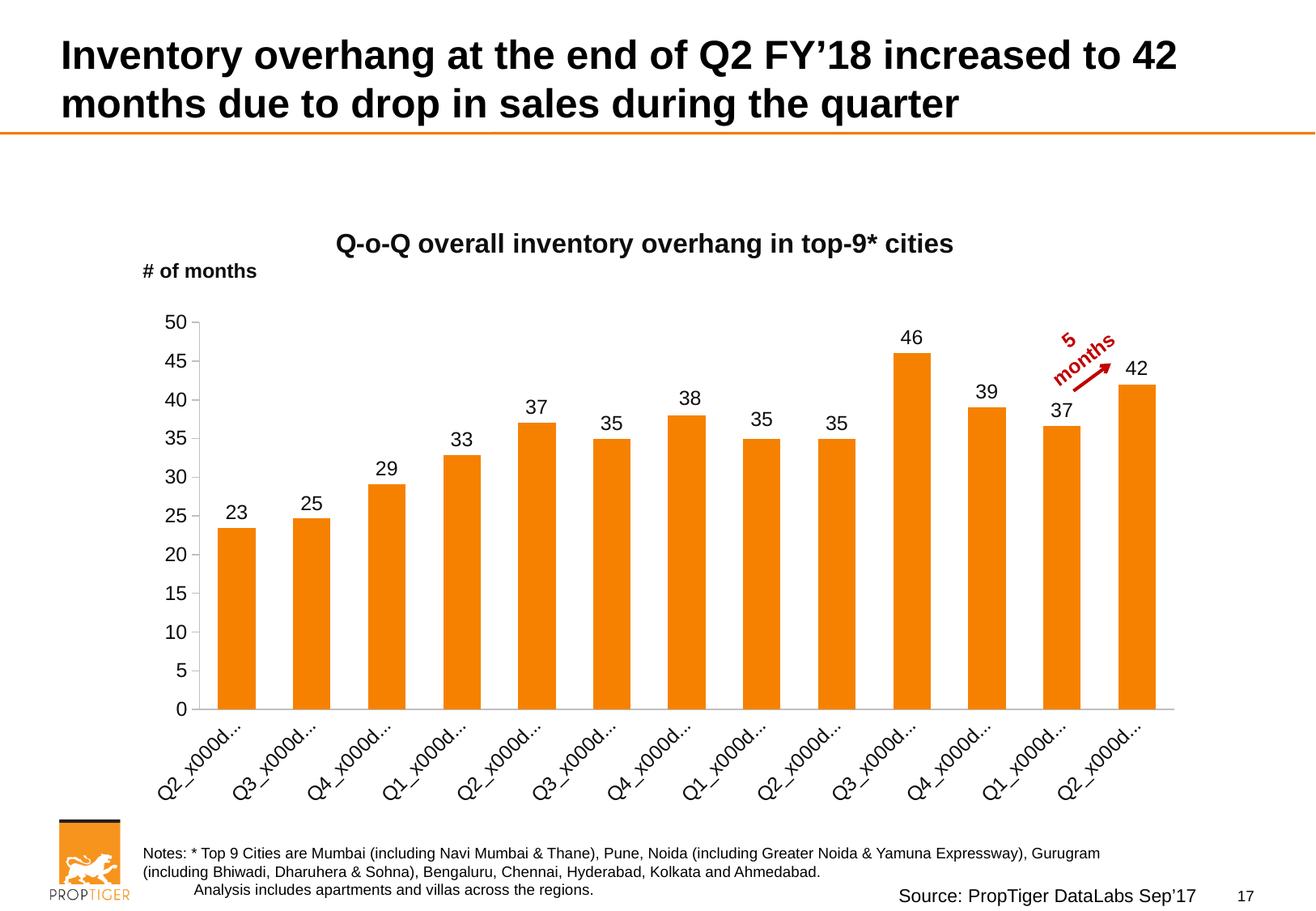
Which is larger, the value of the tenth bar or the value of the eleventh bar? the tenth bar (46) Do the values generally rise or fall from left to right across the chart? rise What kind of chart is shown on the slide? bar chart What is the value of the last (rightmost) bar in the chart? 42 What is the title of the chart? Q-o-Q overall inventory overhang in top-9* cities What is the value of the first (leftmost) bar in the chart? 23 What is the highest value shown in the chart? 46 What is the difference between the highest bar (46) and the lowest bar (23)? 23 How many bars are plotted in the chart? 13 What is the difference between the last bar (42) and the second-to-last bar (37)? 5 What is the lowest value shown in the chart? 23 What unit is shown on the vertical axis label of the chart? # of months